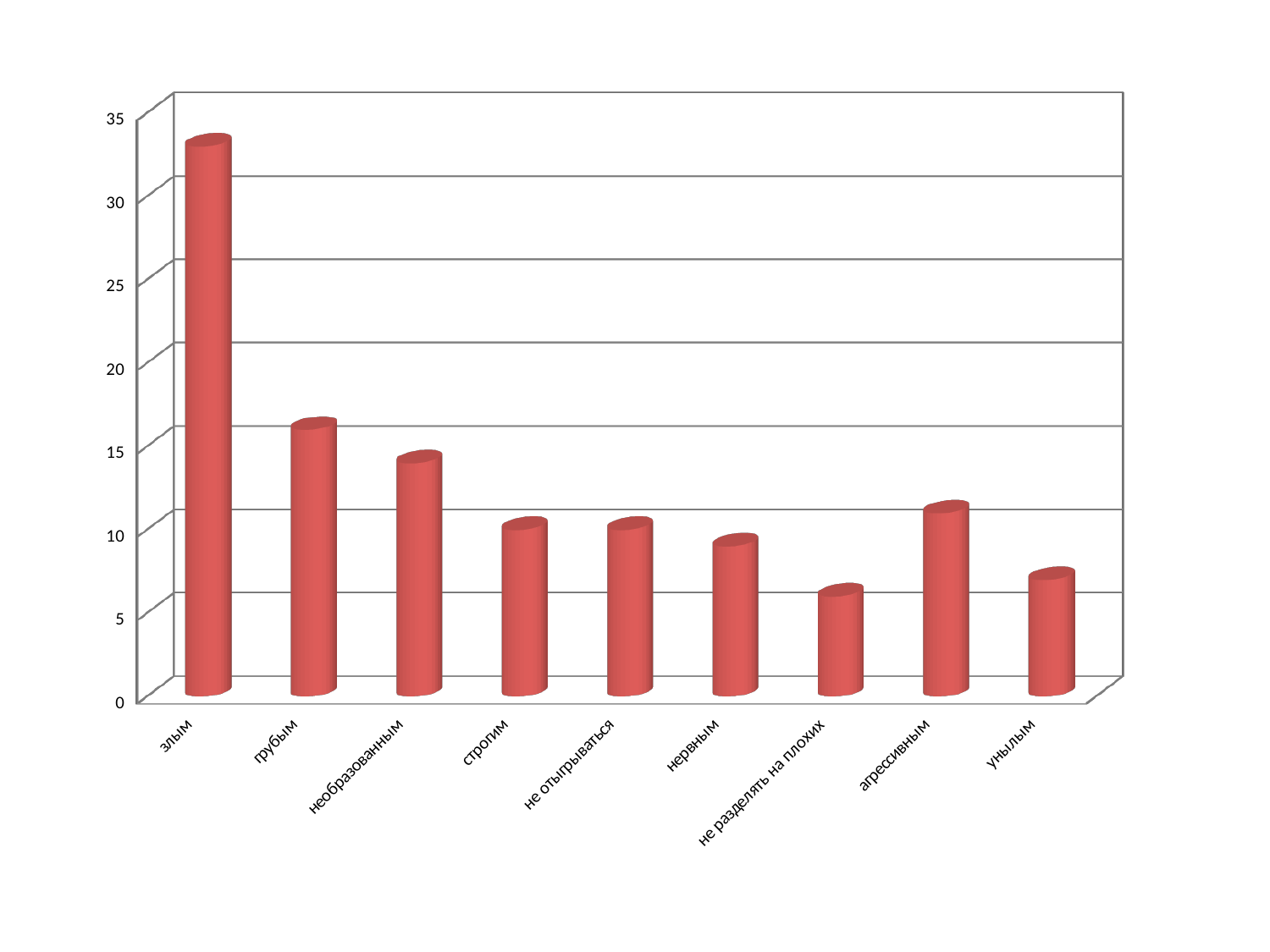
Is the value for грубым greater or less than 15? greater Which category has the highest bar? злым Which is larger, the value for грубым or the value for необразованным? грубым Is the value for необразованным greater or less than 15? less Which is larger, the value for агрессивным or the value for унылым? агрессивным Is the value for злым greater or less than 30? greater Which category has the lowest bar? не разделять на плохих Which is larger, the value for нервным or the value for не разделять на плохих? нервным How many categories are shown on the x axis of the chart? 9 What kind of chart is shown on the slide? bar chart What is the highest value shown on the vertical axis? 35